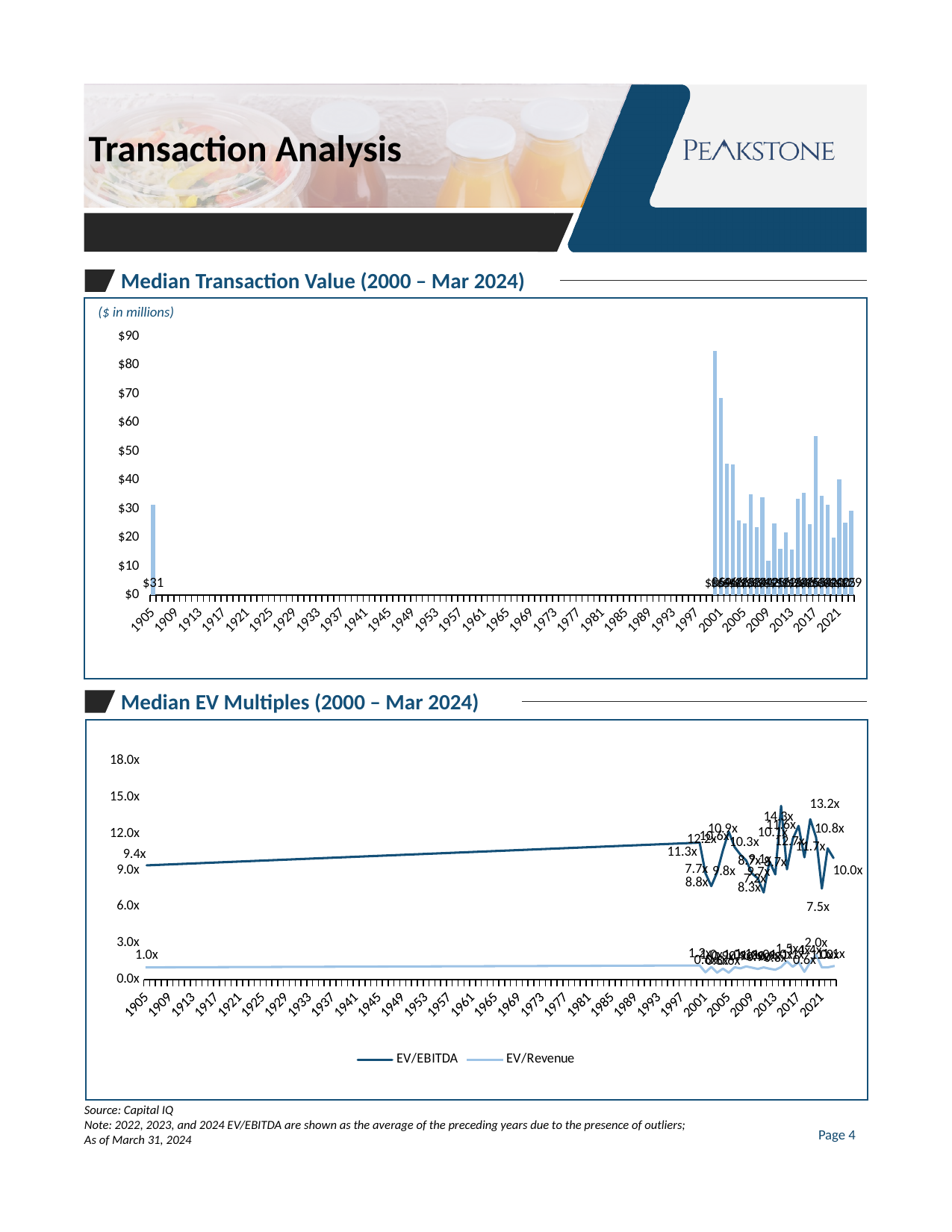
What unit note is shown at the top of the Median Transaction Value chart? ($ in millions) What kind of chart is the Median Transaction Value (2000 – Mar 2024) chart? bar chart In the Median EV Multiples chart, what is the EV/EBITDA value labeled at 1905? 9.4x What kind of chart is the Median EV Multiples (2000 – Mar 2024) chart? line chart What are the two series named in the legend of the Median EV Multiples chart? EV/EBITDA and EV/Revenue In the Median EV Multiples chart, which series has the higher values, EV/EBITDA or EV/Revenue? EV/EBITDA In the Median Transaction Value chart, is the tallest bar greater or less than $80? greater In the Median Transaction Value chart, what is the value labeled for 1905? $31 In the Median EV Multiples chart, what is the highest EV/EBITDA value labeled? 14.3x In the Median EV Multiples chart, what is the EV/Revenue value labeled at 1905? 1.0x How many series does the legend of the Median EV Multiples chart list? 2